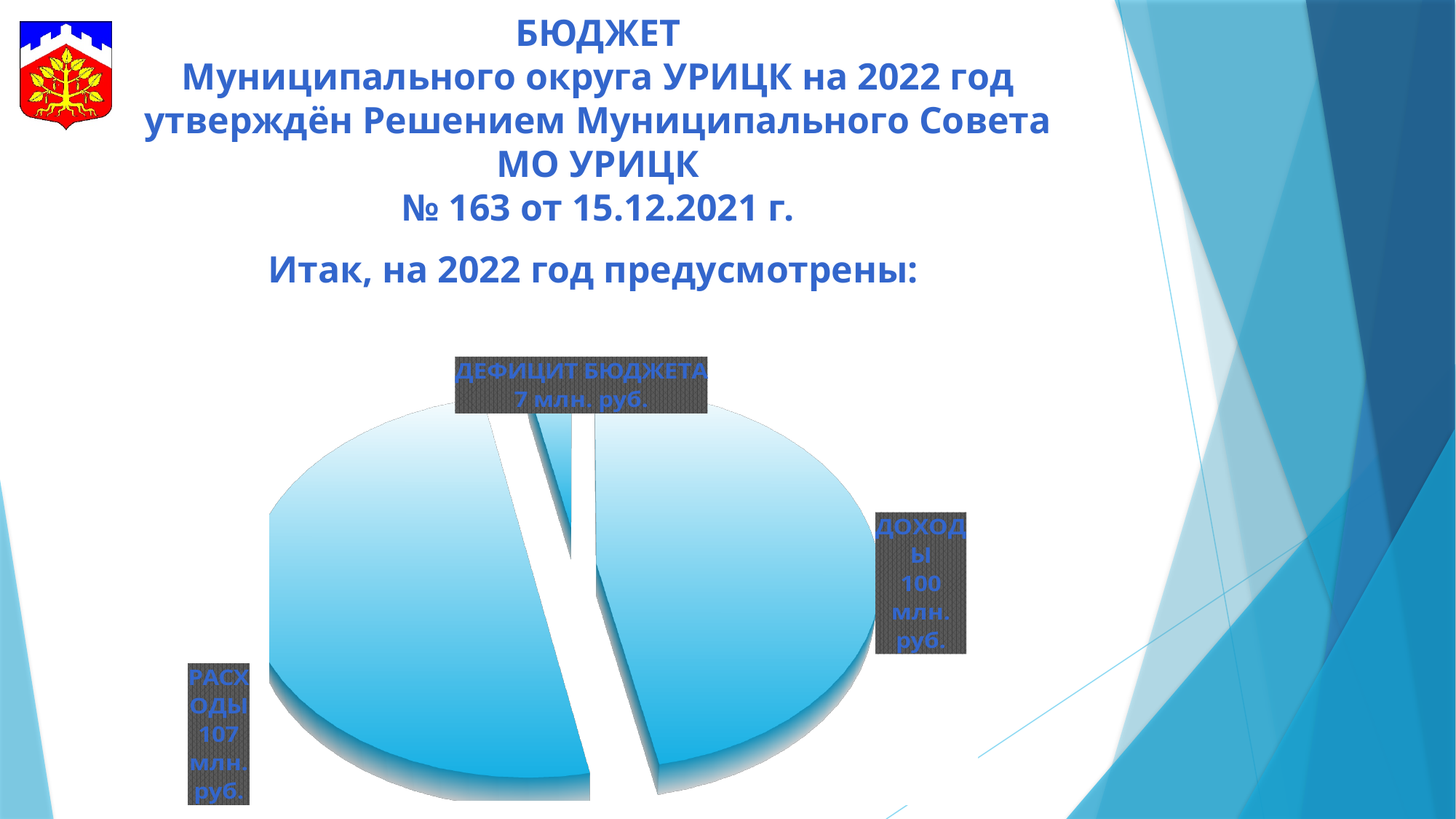
What is the value shown for РАСХОДЫ? 107 млн. руб. How many slices does the pie chart have? 3 What kind of chart is shown on the slide? pie chart What is the value shown for ДЕФИЦИТ БЮДЖЕТА? 7 млн. руб. What year does the budget shown in the chart refer to? 2022 Which slice of the pie chart has the smallest value? ДЕФИЦИТ БЮДЖЕТА What share of the pie chart does the РАСХОДЫ slice represent? 50% Which slice of the pie chart has the largest value? РАСХОДЫ What is the value shown for ДОХОДЫ? 100 млн. руб. Which is larger, ДОХОДЫ or ДЕФИЦИТ БЮДЖЕТА? ДОХОДЫ What is the difference between ДОХОДЫ and ДЕФИЦИТ БЮДЖЕТА? 93 млн. руб. What is the difference between РАСХОДЫ and ДОХОДЫ? 7 млн. руб.